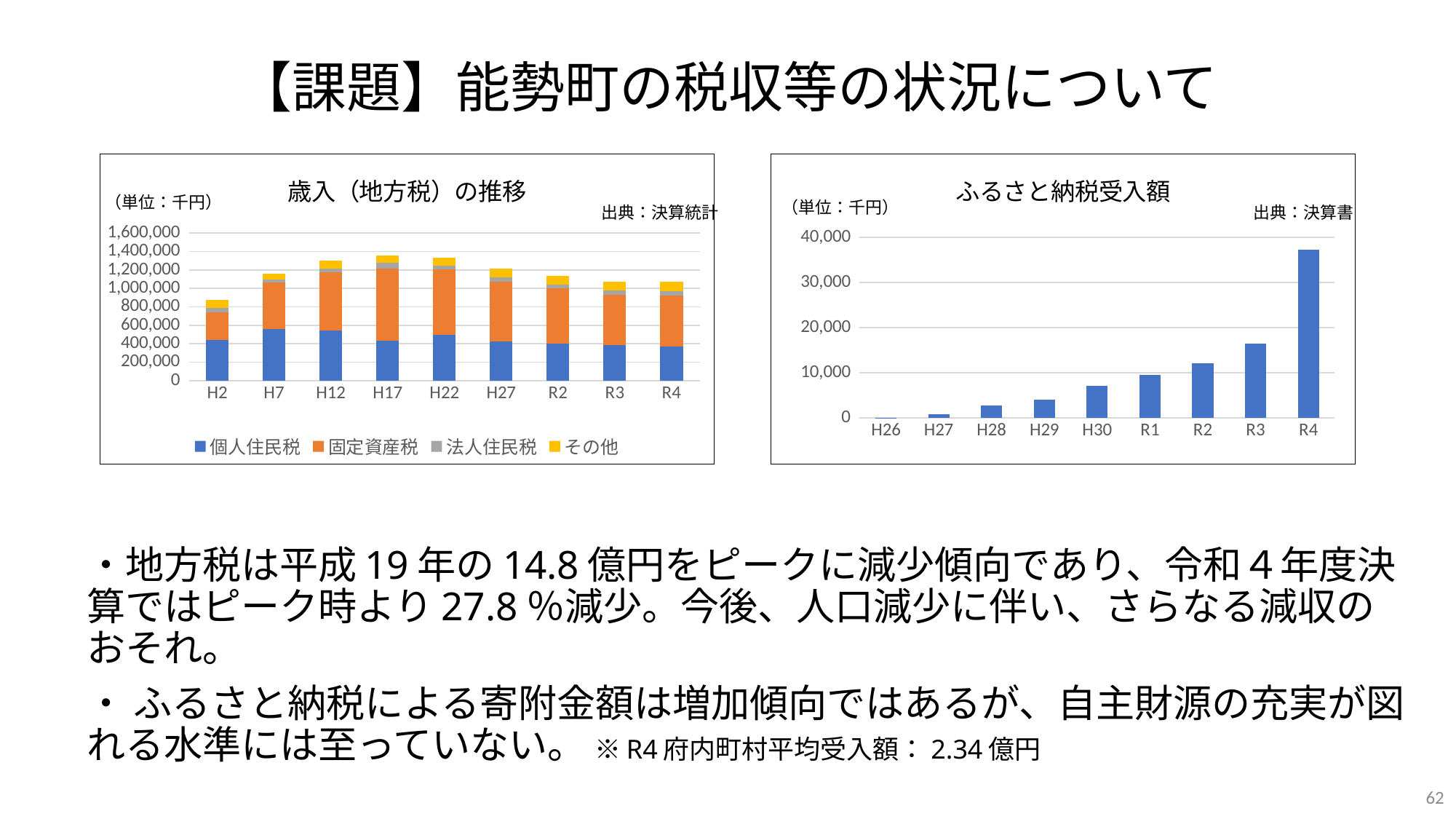
What kind of chart is the right chart titled ふるさと納税受入額? Bar chart In the left chart (歳入（地方税）の推移), is the total for H2 greater or less than 1,000,000? less In the right chart (ふるさと納税受入額), do the values generally rise or fall from H26 to R4? Rise How many series does the legend of the left chart (歳入（地方税）の推移) list? 4 In the right chart (ふるさと納税受入額), is the value for R4 greater or less than 30,000? greater In the left chart (歳入（地方税）の推移), which year has the lowest total bar? H2 How many categories are shown on the x axis of the left chart (歳入（地方税）の推移)? 9 What kind of chart is the left chart titled 歳入（地方税）の推移? Stacked bar chart In the right chart (ふるさと納税受入額), which year has the highest value? R4 How many bars are shown in the right chart (ふるさと納税受入額)? 9 In the left chart (歳入（地方税）の推移), is the total for H17 greater or less than 1,200,000? greater In the left chart (歳入（地方税）の推移), which series is shown in orange according to the legend? 固定資産税